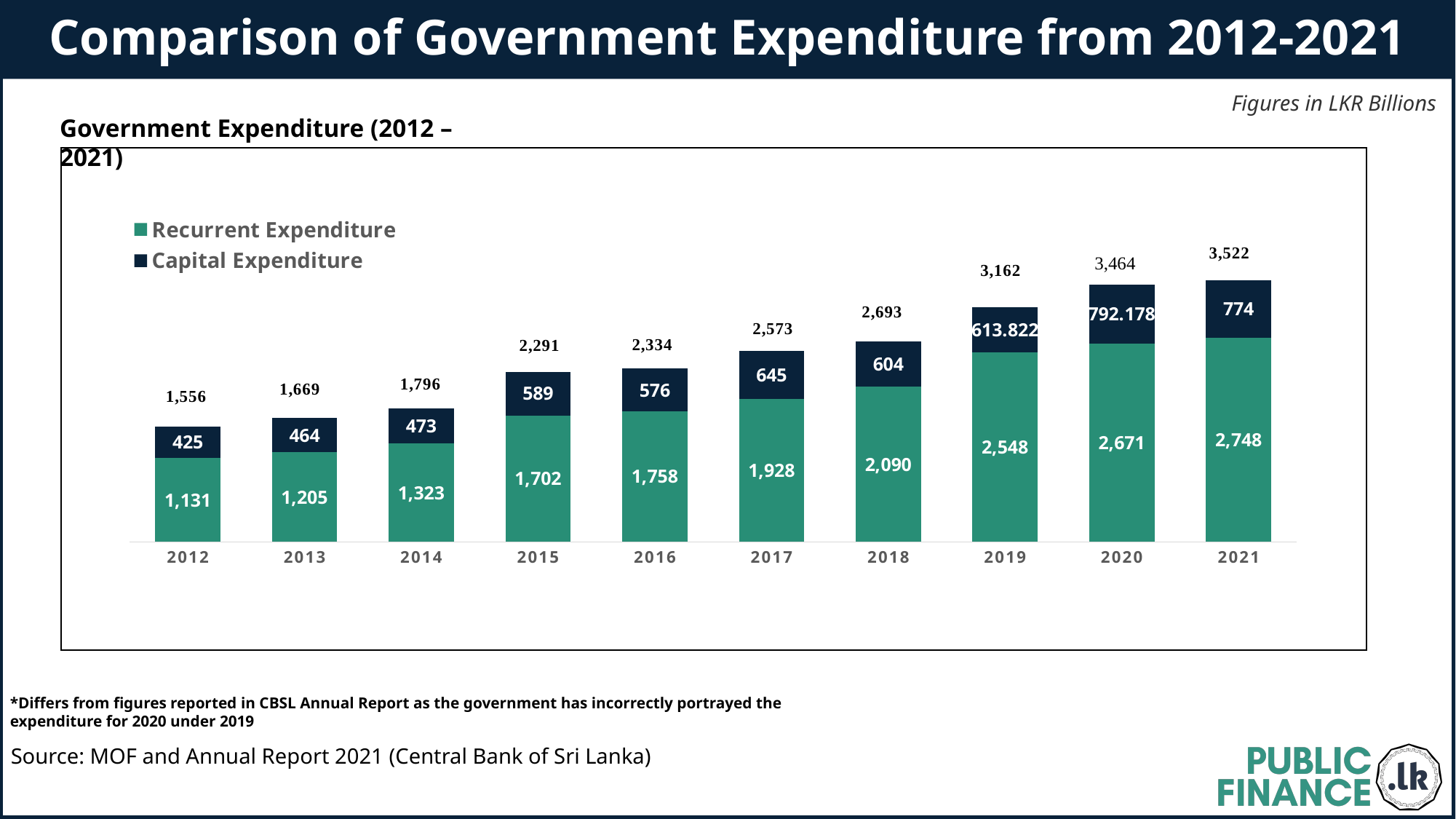
Which year has the lowest Recurrent Expenditure? 2012 What is the total government expenditure shown for 2019? 3,162 What is the difference between Recurrent Expenditure in 2021 and 2020? 77 What is the Recurrent Expenditure value for 2015? 1,702 What is the Capital Expenditure value for 2020? 792.178 How many series does the legend list? 2 What is the Capital Expenditure value for 2018? 604 How many years are shown on the x axis? 10 What kind of chart is shown on the slide? Stacked bar chart Which is larger, Capital Expenditure in 2015 or in 2016? 2015 Which year has the highest total government expenditure? 2021 Do the total expenditure values rise or fall from 2012 to 2021? Rise